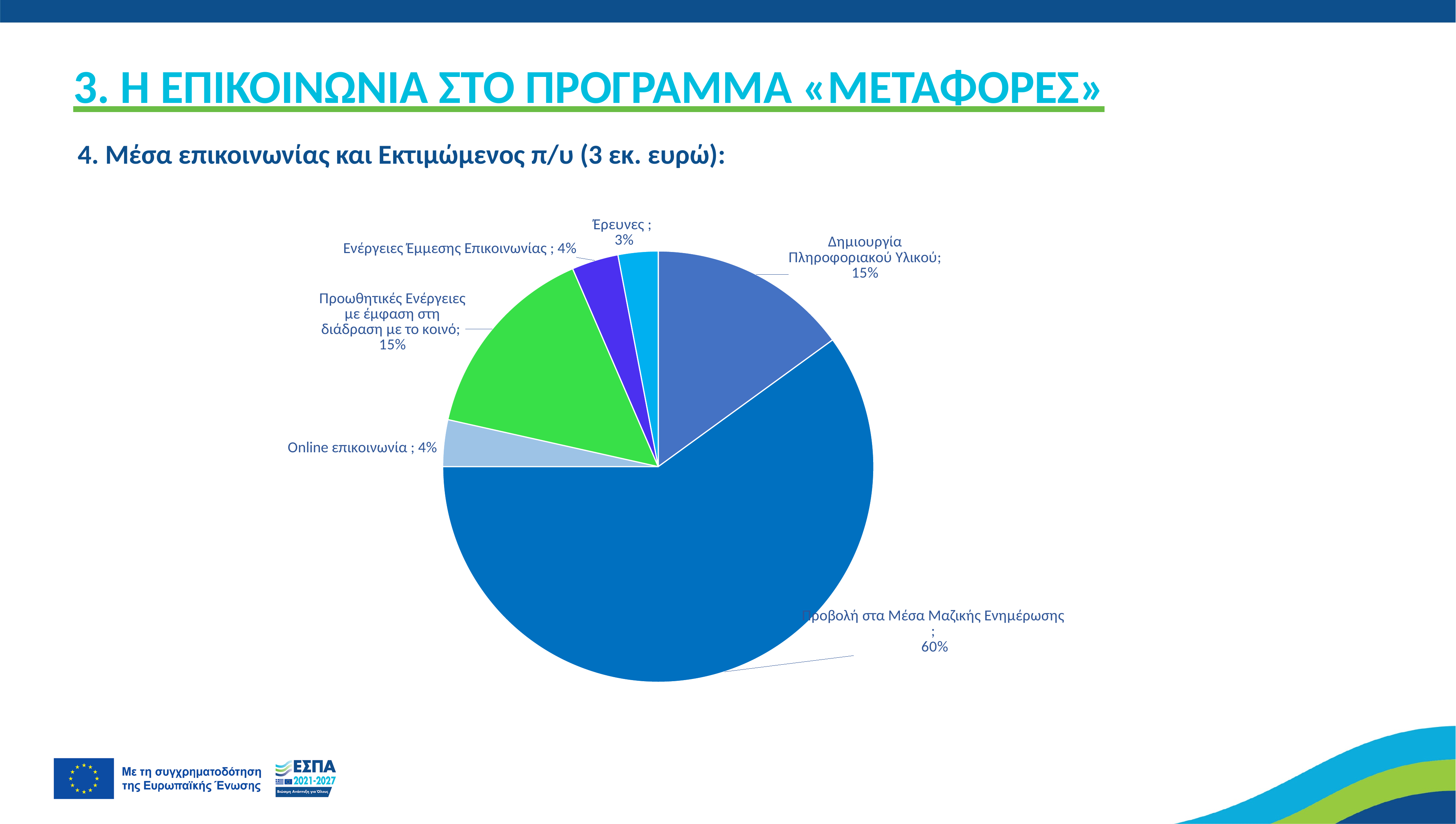
Which category has the smallest slice of the pie? Έρευνες What is the value shown for Προωθητικές Ενέργειες με έμφαση στη διάδραση με το κοινό? 15% Which is larger, the share for Ενέργειες Έμμεσης Επικοινωνίας or the share for Έρευνες? Ενέργειες Έμμεσης Επικοινωνίας What type of chart is shown on the slide? Pie chart What share of the pie does Προβολή στα Μέσα Μαζικής Ενημέρωσης represent? 60% What is the value shown for Δημιουργία Πληροφοριακού Υλικού? 15% What is the difference between the share for Προβολή στα Μέσα Μαζικής Ενημέρωσης and the share for Δημιουργία Πληροφοριακού Υλικού? 45% What is the value shown for Online επικοινωνία? 4% What is the value shown for Έρευνες? 3% Which category has the largest slice of the pie? Προβολή στα Μέσα Μαζικής Ενημέρωσης How many slices does the pie chart have? 6 What colour is the slice for Προωθητικές Ενέργειες με έμφαση στη διάδραση με το κοινό? Green